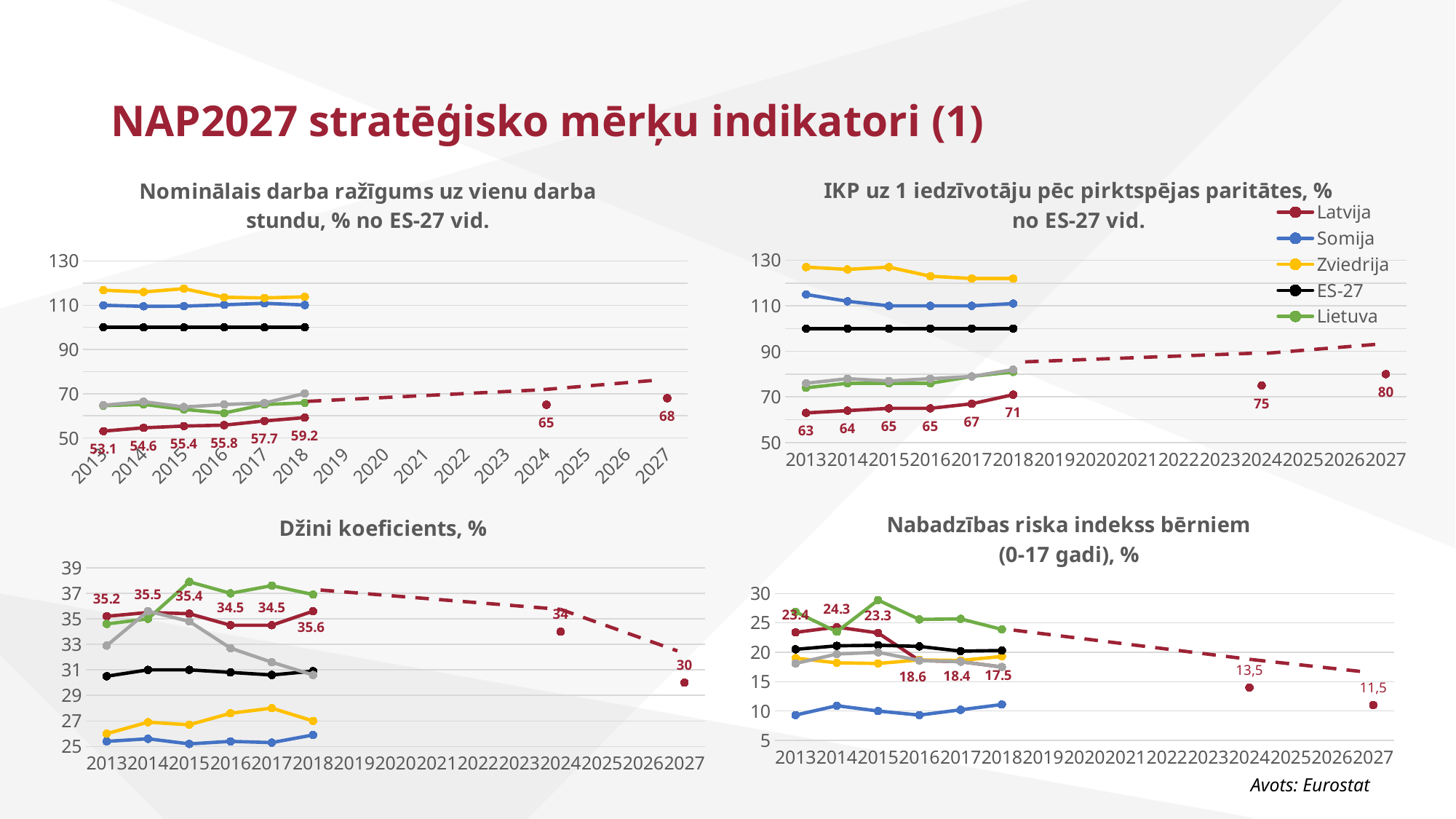
In the chart 'IKP uz 1 iedzīvotāju pēc pirktspējas paritātes, % no ES-27 vid.', what is the value for Latvija in 2018? 71 In the chart 'Džini koeficients, %', what is the value for Latvija in 2018? 35.6 In the chart 'IKP uz 1 iedzīvotāju pēc pirktspējas paritātes, % no ES-27 vid.', how many series does the legend list? 5 In the chart 'Nominālais darba ražīgums uz vienu darba stundu, % no ES-27 vid.', what is the difference between the Latvija values for 2018 and 2013? 6.1 In the chart 'Nabadzības riska indekss bērniem (0-17 gadi), %', what is the labelled value for Latvija in 2027? 11,5 In the chart 'Nominālais darba ražīgums uz vienu darba stundu, % no ES-27 vid.', what is the value for Latvija in 2013? 53.1 What kind of chart is 'Džini koeficients, %'? line chart In the chart 'Nominālais darba ražīgums uz vienu darba stundu, % no ES-27 vid.', what is the labelled value for Latvija in 2027? 68 In the chart 'IKP uz 1 iedzīvotāju pēc pirktspējas paritātes, % no ES-27 vid.', do the labelled Latvija values rise or fall from 2013 to 2027? rise In the chart 'Nabadzības riska indekss bērniem (0-17 gadi), %', what is the value for Latvija in 2014? 24.3 In the chart 'Džini koeficients, %', which year has the lowest labelled Latvija value? 2027 In the chart 'IKP uz 1 iedzīvotāju pēc pirktspējas paritātes, % no ES-27 vid.', is the value for Somija in 2013 greater or less than 110? greater